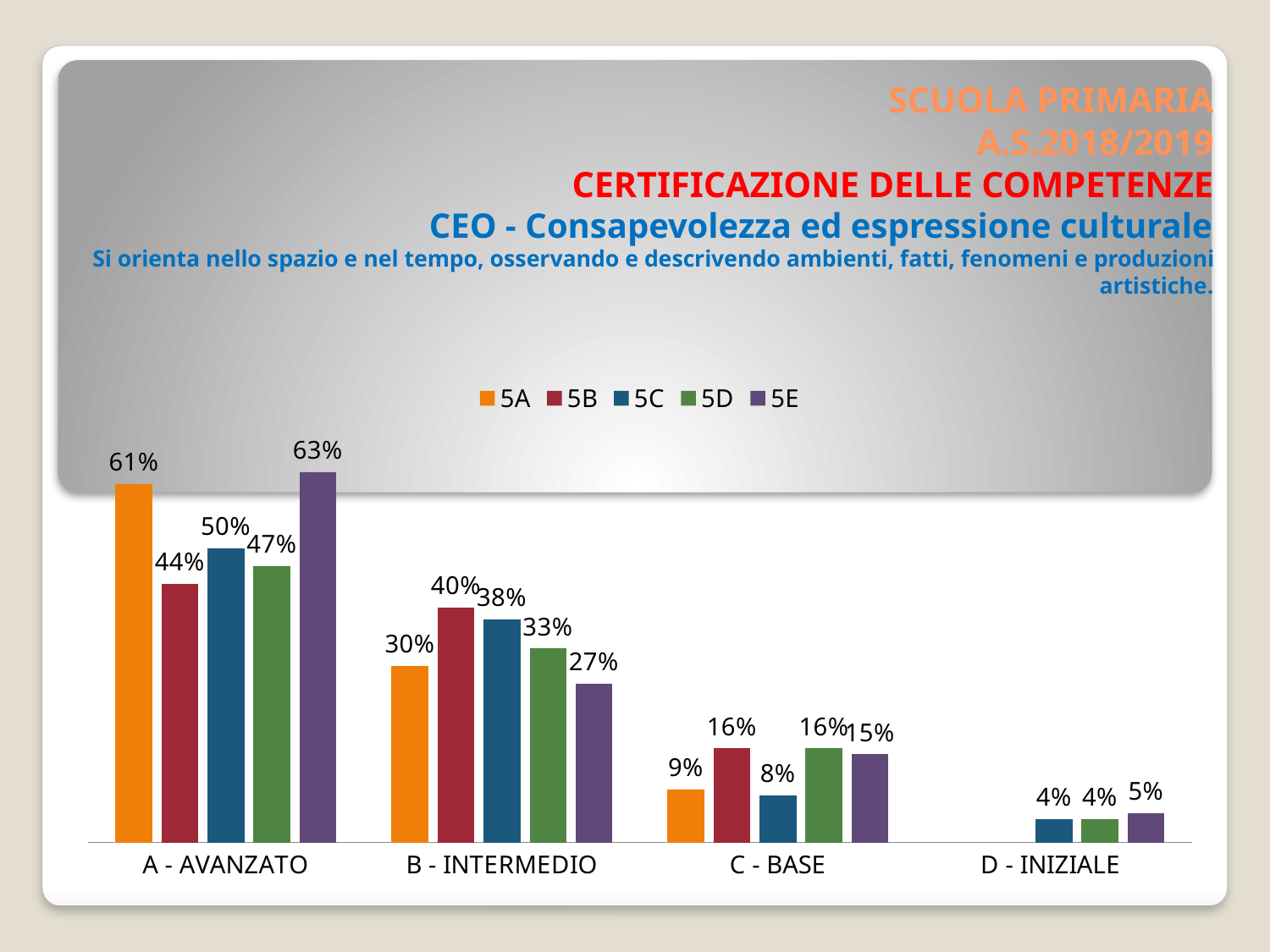
What is the value for 5E in the A - AVANZATO category? 63% What is the value for 5A in the B - INTERMEDIO category? 30% Which series has the highest value in the A - AVANZATO category? 5E How many categories are shown on the x axis? 4 Which series has the lowest value in the B - INTERMEDIO category? 5E What is the difference between the 5A and 5B values in the A - AVANZATO category? 17% Which is larger in the B - INTERMEDIO category, the value for 5B or the value for 5D? 5B Do the values for 5C rise or fall from A - AVANZATO to D - INIZIALE? Fall What kind of chart is shown on the slide? Bar chart Which series is shown in orange in the legend? 5A How many series does the legend list? 5 What is the value for 5C in the C - BASE category? 8%